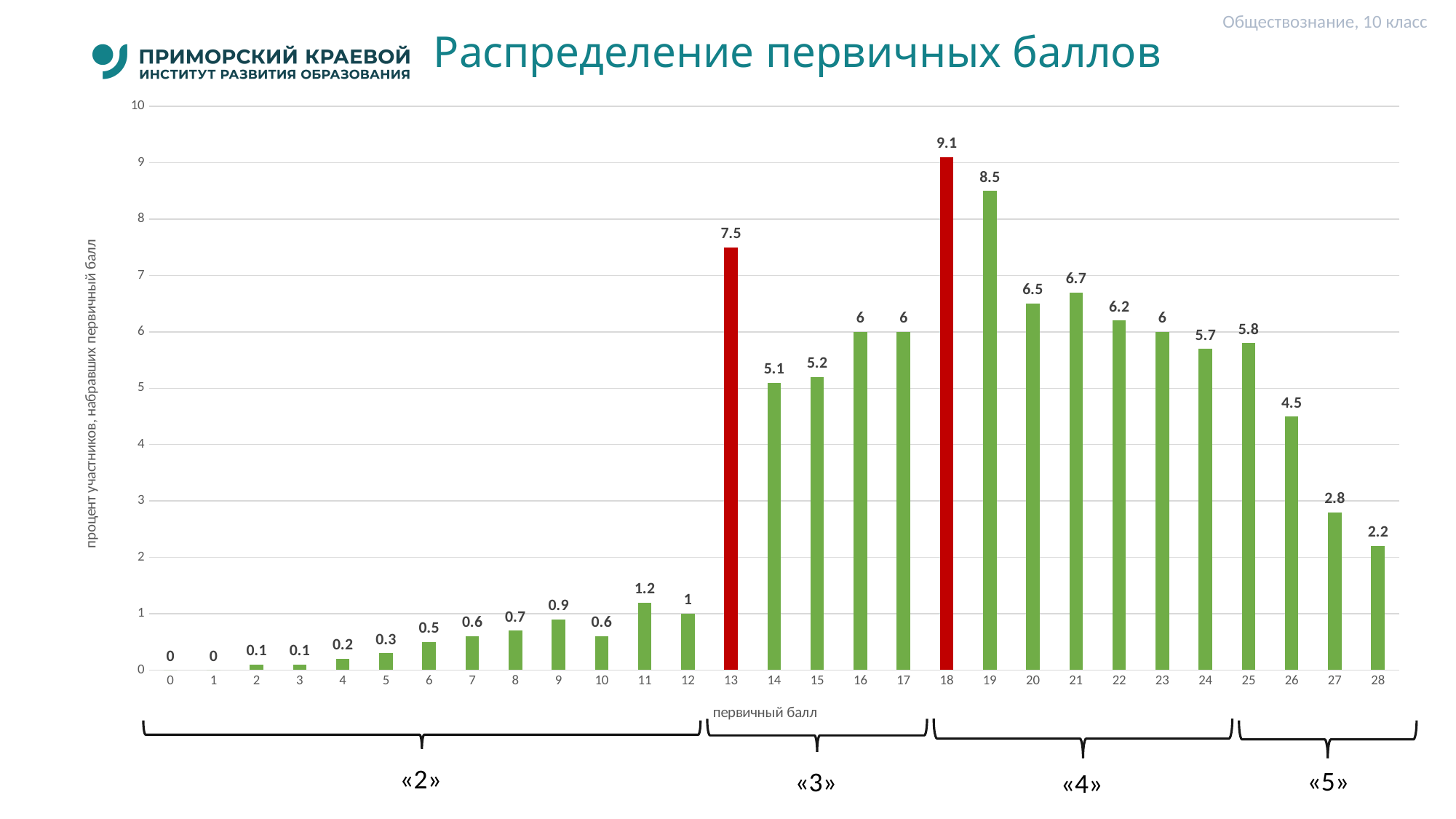
Which has a larger value, primary score 20 or primary score 21? 21 What is the difference between the values for primary scores 18 and 19? 0.6 Which primary score has the highest value? 18 What is the value for primary score 26? 4.5 How many primary score categories are shown on the x axis? 29 What is the value for primary score 18? 9.1 Do the values rise or fall from primary score 19 to primary score 28? fall Which two primary scores are shown with red bars? 13 and 18 What is the lowest value shown on the chart? 0 What kind of chart is shown on the slide? bar chart What is the value for primary score 11? 1.2 What is the value for primary score 13? 7.5